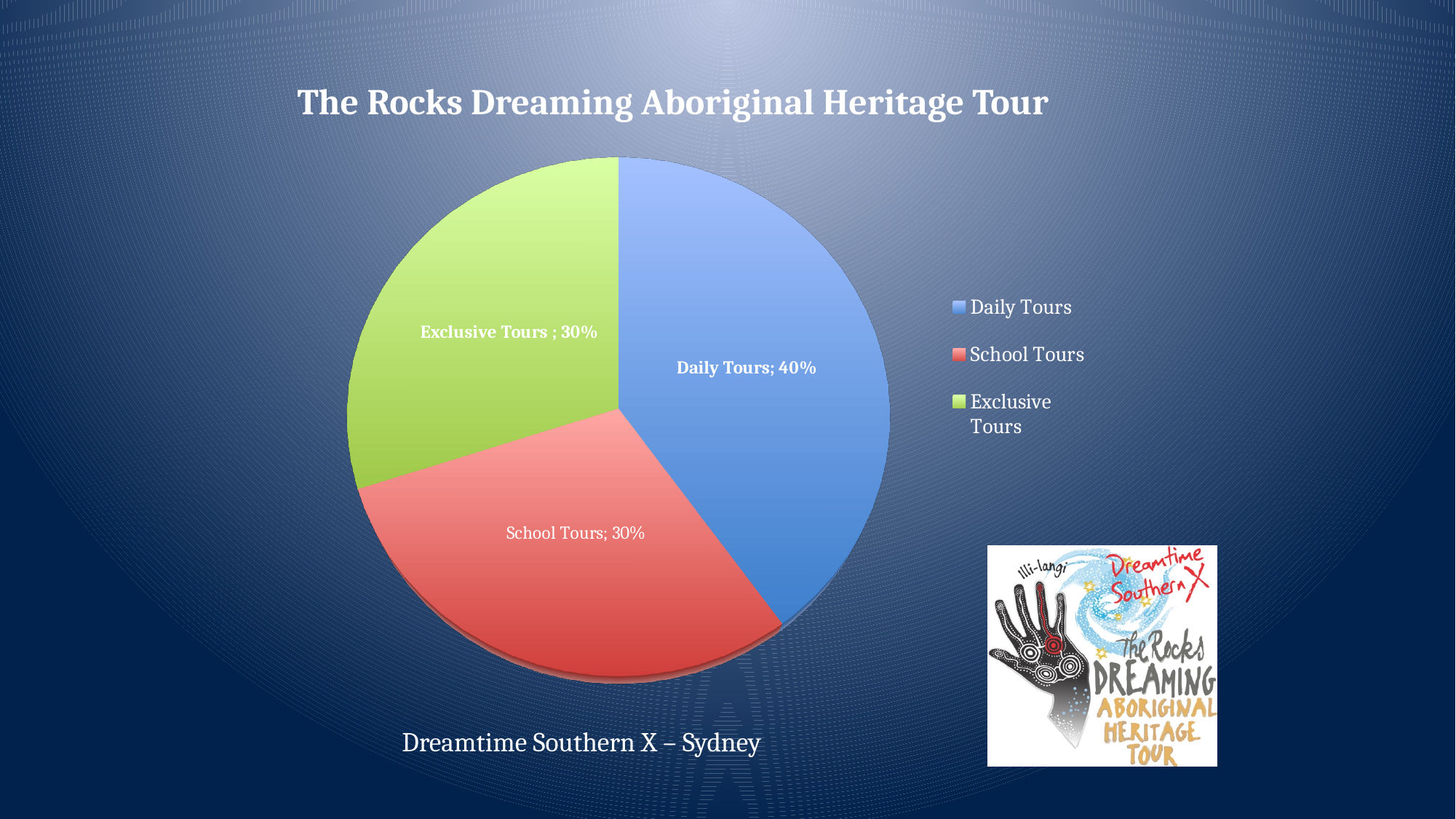
What is the title of the chart? The Rocks Dreaming Aboriginal Heritage Tour What share of the pie does Exclusive Tours have? 30% What share of the pie does Daily Tours have? 40% What is the combined share of School Tours and Exclusive Tours? 60% What colour is the School Tours slice? Red Which is larger, the Daily Tours slice or the Exclusive Tours slice? Daily Tours What share of the pie does School Tours have? 30% Which category has the largest slice of the pie? Daily Tours What kind of chart is shown on the slide? Pie chart What is the difference between the Daily Tours share and the School Tours share? 10% How many slices does the pie chart have? 3